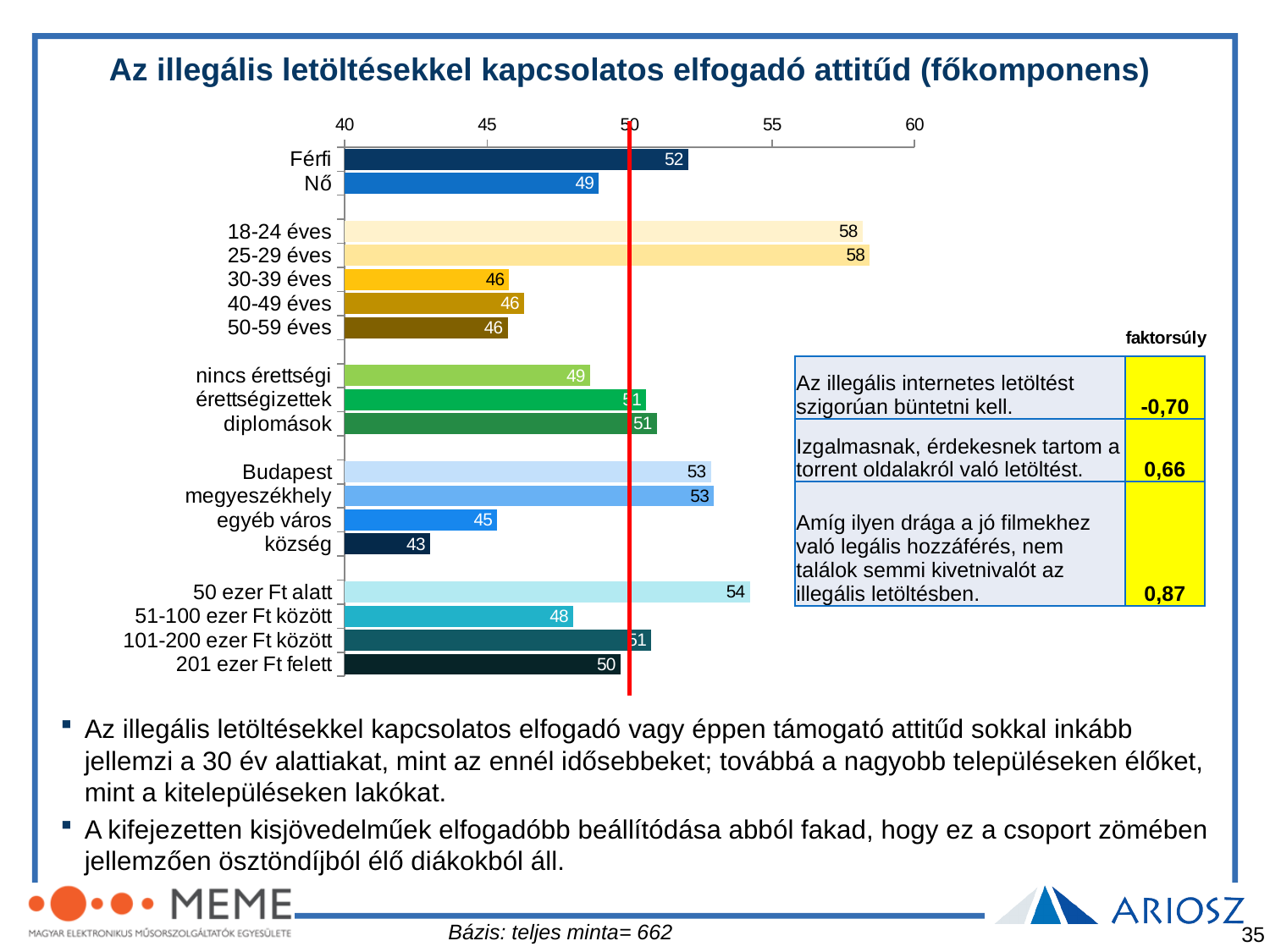
What kind of chart is shown on the slide? bar chart What is the difference between the values for Budapest and község? 10 Is the value for 18-24 éves greater or less than 55? greater What is the difference between the values for Férfi and Nő? 3 What is the value for Férfi? 52 Among the settlement-type categories (Budapest, megyeszékhely, egyéb város, község), which has the lowest value? község Which category has the lowest value in the chart? község What is the value for 50 ezer Ft alatt? 54 How many categories (bars) are shown in the chart? 18 What is the value for község? 43 Which is larger, the value for 50 ezer Ft alatt or the value for 51-100 ezer Ft között? 50 ezer Ft alatt What is the value for 25-29 éves? 58